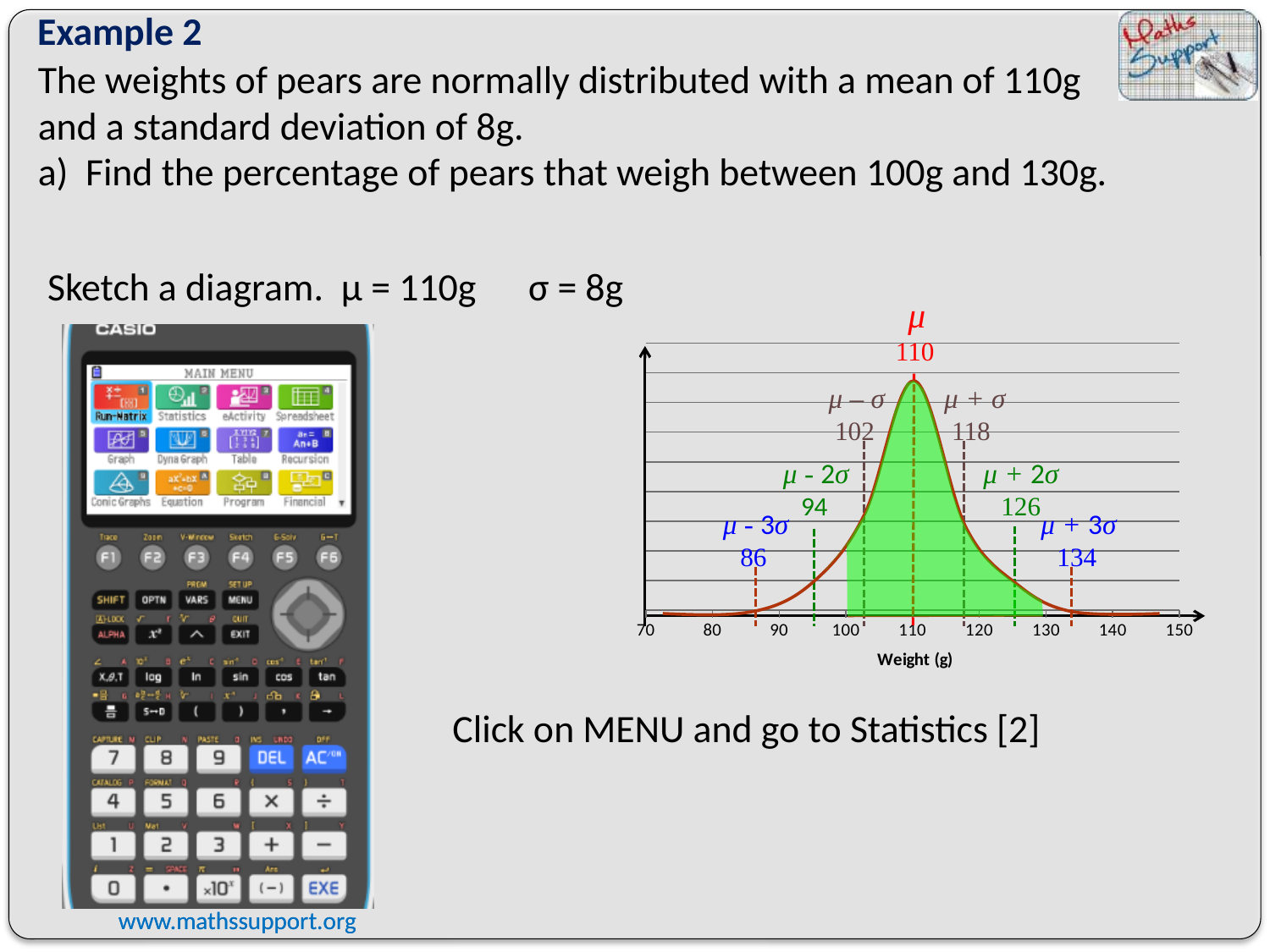
What kind of chart is shown on the slide? A normal distribution (bell) curve What is the label on the x axis of the chart? Weight (g) What value is labelled at μ + σ on the chart? 118 What is the difference between the values labelled at μ + σ and μ − σ? 16 What value is labelled at μ − σ on the chart? 102 How many tick labels are shown on the x axis of the chart? 9 What value is marked at the mean μ on the normal distribution chart? 110 What value is labelled at μ − 2σ on the chart? 94 Between which two x-axis values is the region under the curve shaded green? 100 and 130 Which is larger, the value labelled at μ + 2σ or the value labelled at μ − 3σ? μ + 2σ What is the difference between the values labelled at μ + 3σ and μ − 3σ? 48 What value is labelled at μ + 3σ on the chart? 134